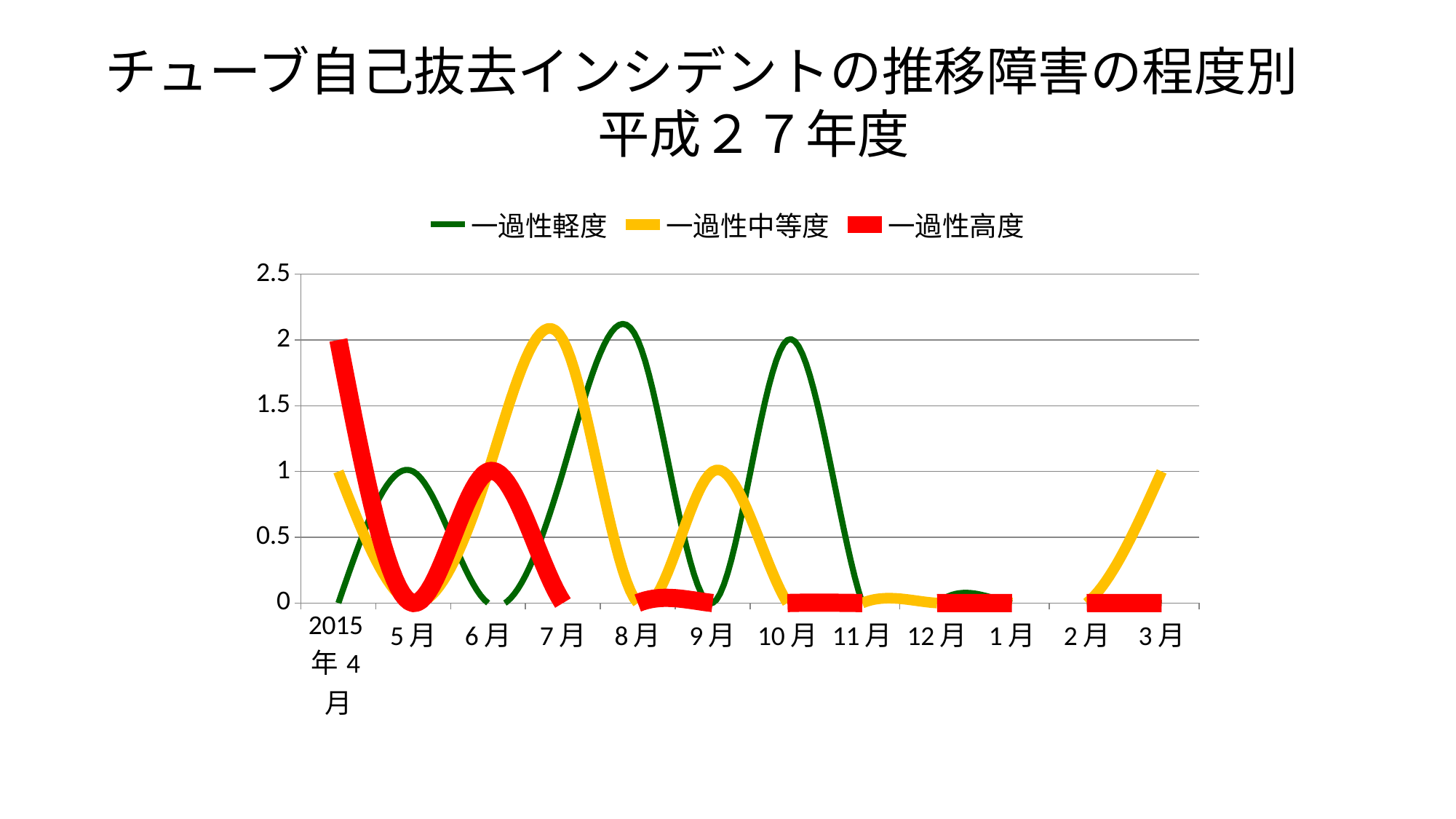
Which is larger: 一過性軽度 in 10月 or 一過性中等度 in 9月? 一過性軽度 in 10月 How many months are shown along the x axis? 12 What is the value of 一過性高度 in 6月? 1 How many series does the legend list? 3 Is the value of 一過性軽度 in 8月 greater or less than 1.5? greater In which month is 一過性高度 highest? 2015年4月 What is the value of 一過性中等度 in 3月? 1 What is the value of 一過性高度 in 2015年4月? 2 What kind of chart is shown on the slide? line chart Does 一過性高度 generally rise or fall from 2015年4月 to 3月? fall What is the value of 一過性軽度 in 5月? 1 Which colour represents 一過性中等度 in the chart? yellow